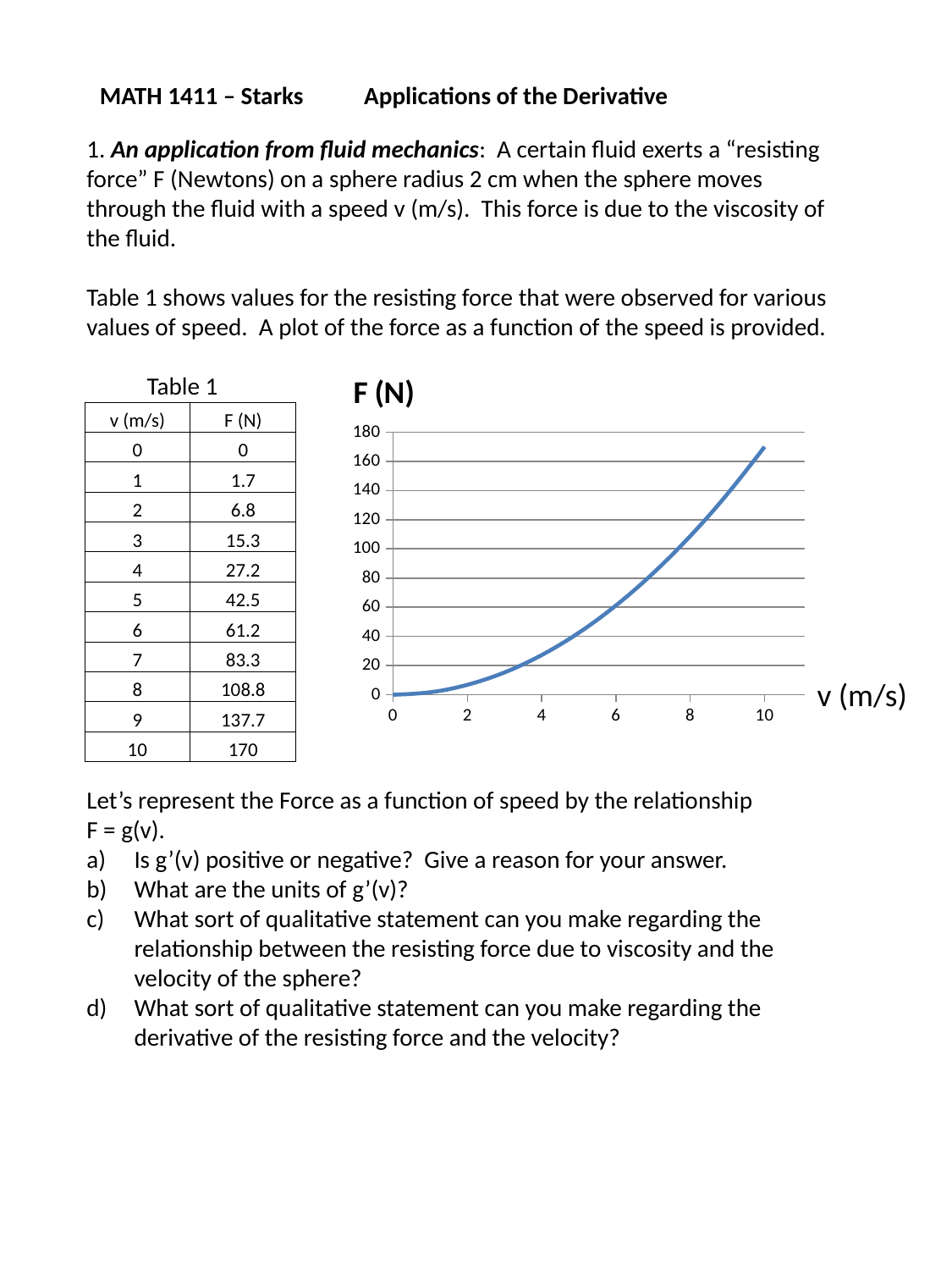
Using Table 1, what is the difference between the force at v = 10 and the force at v = 9? 32.3 According to Table 1, what is the resisting force F when v = 8 m/s? 108.8 At which speed v is the plotted force F lowest? 0 Is the plotted force at v = 4 greater or less than 40? less According to Table 1, what is the resisting force F when v = 5 m/s? 42.5 Is the plotted force at v = 8 greater or less than 100? greater At which speed v is the plotted force F highest? 10 How many data points (speed values) are plotted on the chart? 11 According to Table 1, what is the resisting force F when v = 10 m/s? 170 Does the resisting force F rise or fall as the speed v increases along the x axis? rises What kind of chart is shown on the slide? line chart What label is shown on the horizontal axis of the chart? v (m/s)